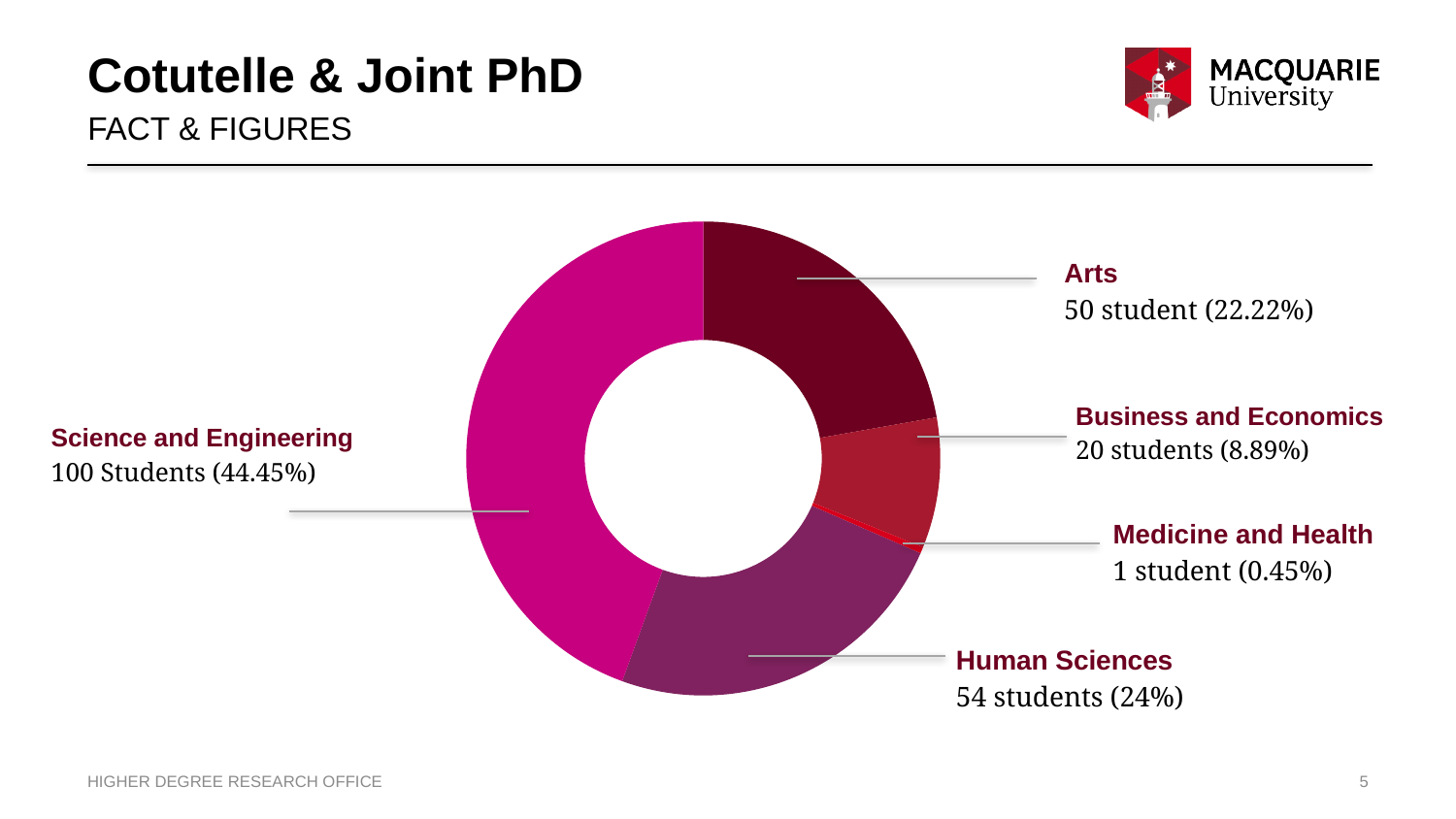
What is the difference in number of students between Science and Engineering and Arts? 50 Which category has the smallest share of the chart? Medicine and Health What kind of chart is shown on the slide? Donut (pie) chart How many students are in the Business and Economics category? 20 What is the difference in number of students between Human Sciences and Business and Economics? 34 How many categories does the chart show? 5 Which category has the largest share of the chart? Science and Engineering What percentage is shown for Medicine and Health? 0.45% Which has more students, Human Sciences or Arts? Human Sciences How many students are in the Arts category? 50 What percentage is shown for Human Sciences? 24% What share of the chart does Science and Engineering represent? 44.45%